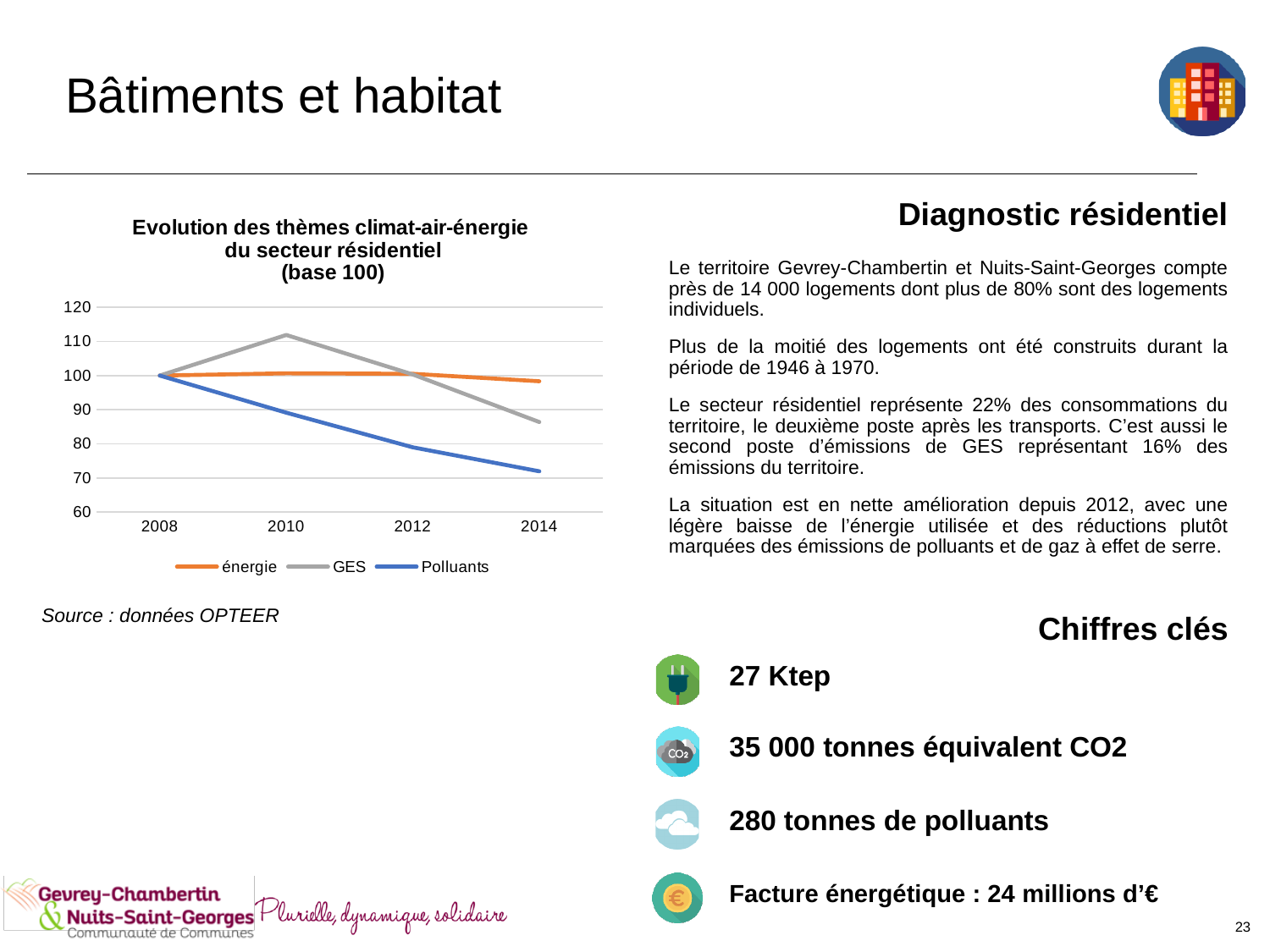
What is the title of the chart? Evolution des thèmes climat-air-énergie du secteur résidentiel (base 100) Which series has the highest value in 2010? GES Which series has the lowest value in 2014? Polluants Is the value for GES in 2010 greater or less than 110? greater In 2014, which is larger: the value for énergie or the value for GES? énergie Does the Polluants series rise or fall from 2008 to 2014? fall How many series does the legend of the chart list? 3 What is the value of all three series in 2008? 100 Is the value for GES in 2014 greater or less than 90? less Is the value for Polluants in 2014 greater or less than 80? less How many years are shown on the x axis of the chart? 4 What kind of chart is shown on the slide? line chart